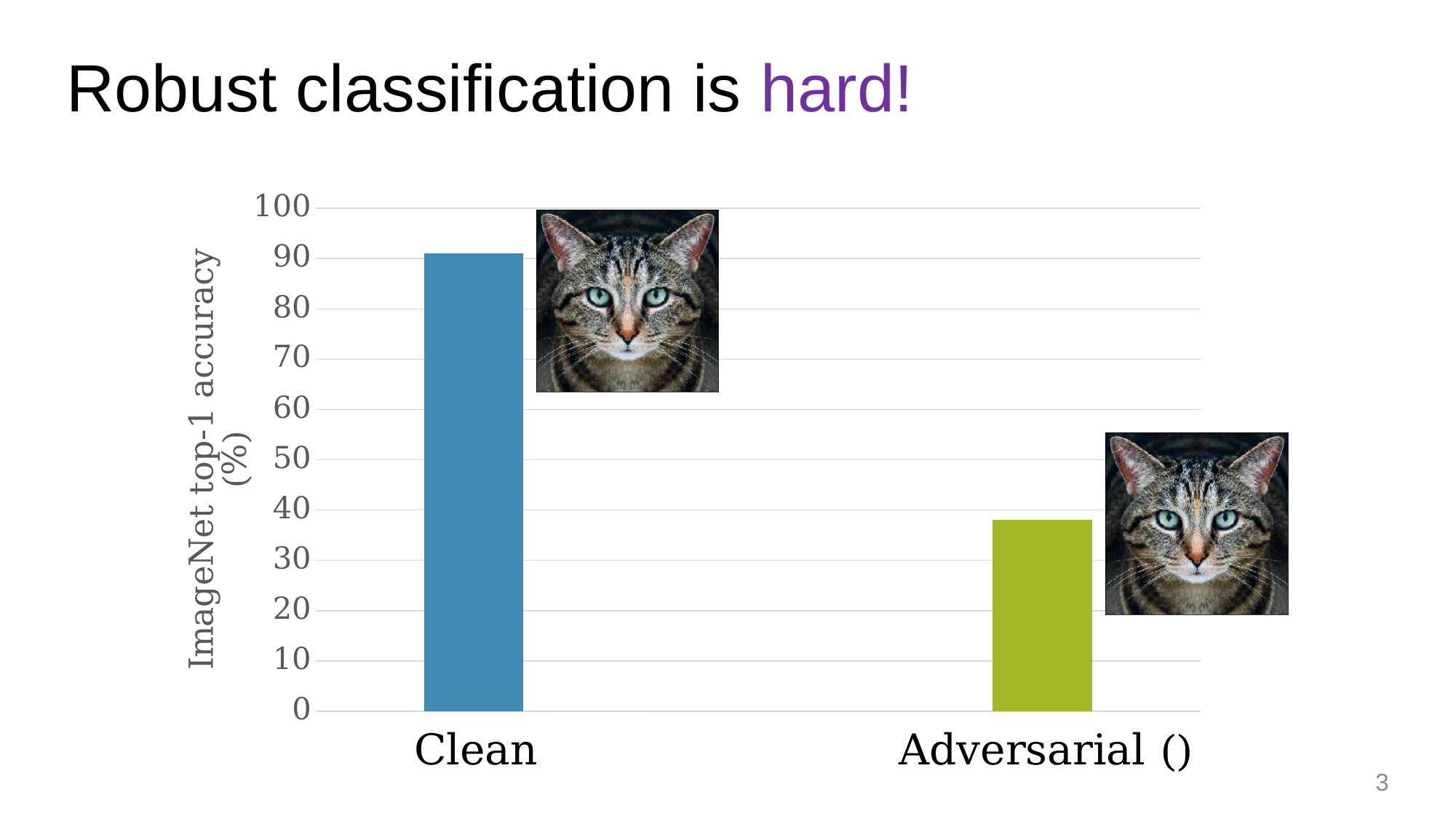
What colour is the bar for Clean? blue Which is larger, the accuracy for Clean or for Adversarial ()? Clean How many bars does the chart show? 2 Which category has the highest ImageNet top-1 accuracy? Clean What kind of chart is shown on the slide? bar chart Is the value for Adversarial () greater or less than 50? less Is the value for Clean greater or less than 80? greater Which category has the lowest ImageNet top-1 accuracy? Adversarial () Is the value for Clean greater or less than 100? less What is the label of the vertical axis? ImageNet top-1 accuracy (%) Do the values rise or fall from Clean to Adversarial () along the x axis? fall